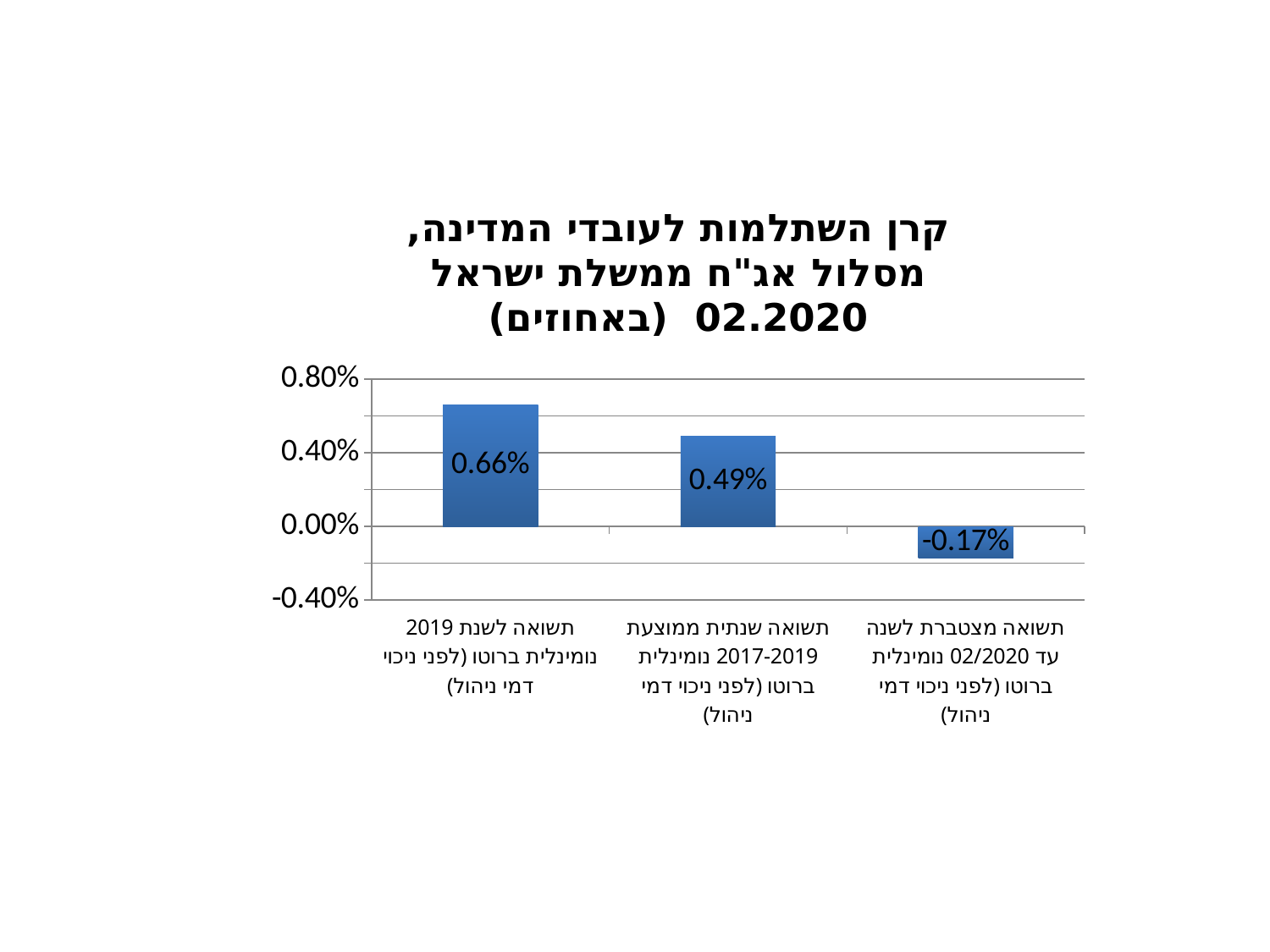
Is the value for the cumulative return to 02/2020 greater or less than 0.00%? less What is the difference between the 2019 return (0.66%) and the 2017-2019 average annual return (0.49%)? 0.17% What is the value of the bar for תשואה לשנת 2019 נומינלית ברוטו (לפני ניכוי דמי ניהול)? 0.66% What is the value of the bar for תשואה שנתית ממוצעת 2017-2019 נומינלית ברוטו (לפני ניכוי דמי ניהול)? 0.49% What is the value of the bar for תשואה מצטברת לשנה עד 02/2020 נומינלית ברוטו (לפני ניכוי דמי ניהול)? -0.17% Which is larger: the return for 2019 or the average annual return for 2017-2019? The return for 2019 (0.66%) What type of chart is shown on the slide? Bar chart Do the bar values rise or fall from left to right across the chart? Fall What is the title of the chart? קרן השתלמות לעובדי המדינה, מסלול אג"ח ממשלת ישראל 02.2020 (באחוזים) Which category has the lowest value? תשואה מצטברת לשנה עד 02/2020 נומינלית ברוטו (לפני ניכוי דמי ניהול) How many bars are shown in the chart? 3 Which category has the highest value? תשואה לשנת 2019 נומינלית ברוטו (לפני ניכוי דמי ניהול)